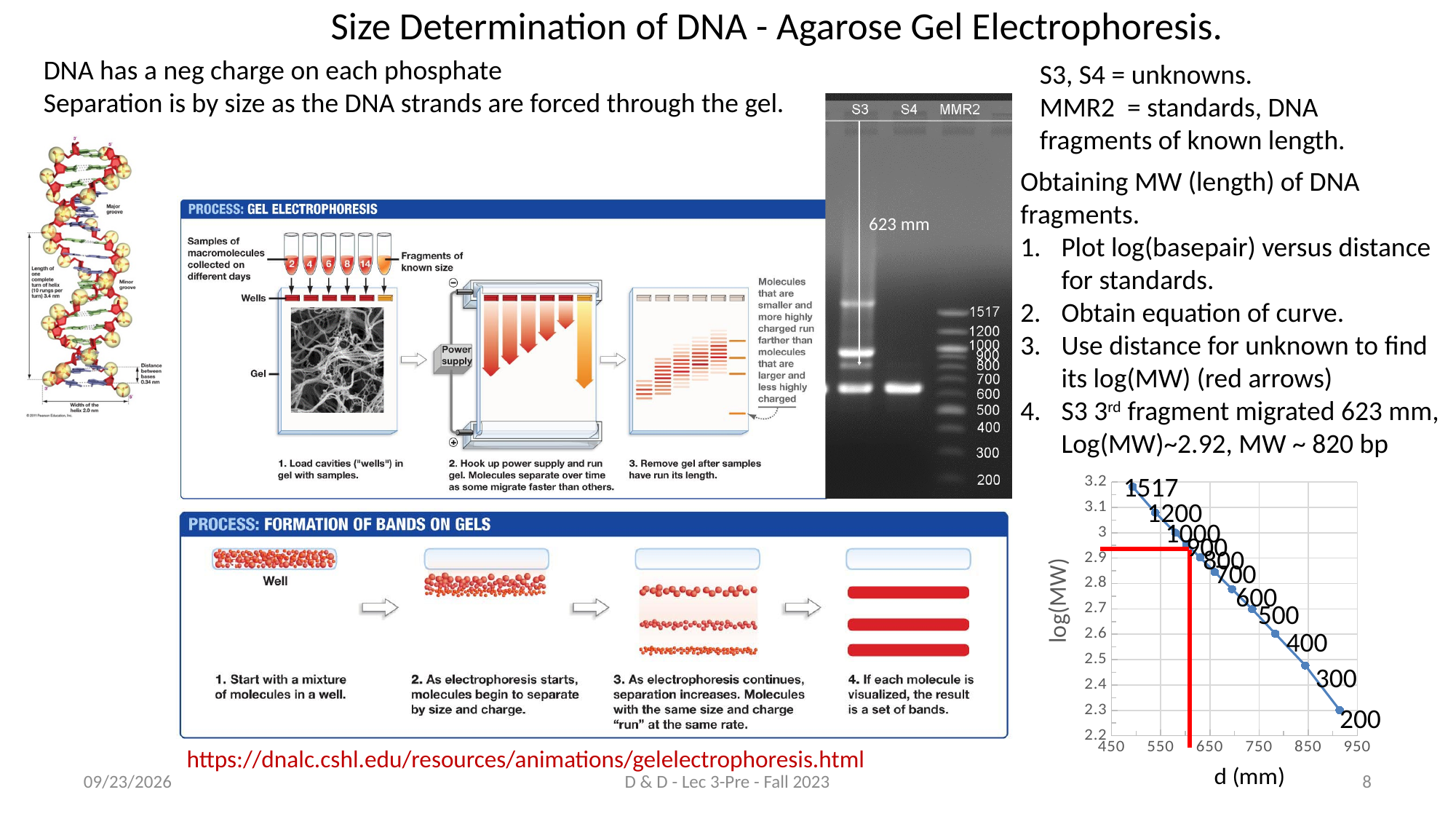
Is the d (mm) value for the point labelled 1517 greater or less than 550? less On the log(MW) versus d (mm) chart, do the values rise or fall as d increases? fall Is the d (mm) value for the point labelled 200 greater or less than 850? greater What kind of chart is shown at the bottom right of the slide? scatter chart Which labelled point on the chart has the highest log(MW)? 1517 How many data points are plotted on the log(MW) versus d (mm) chart? 11 Which point has a larger log(MW) value, the one labelled 1200 or the one labelled 300? 1200 Is the log(MW) value for the point labelled 1517 greater or less than 3.1? greater What is the label of the y axis on the chart? log(MW) What is the label of the x axis on the chart? d (mm) Which labelled point on the chart has the lowest log(MW)? 200